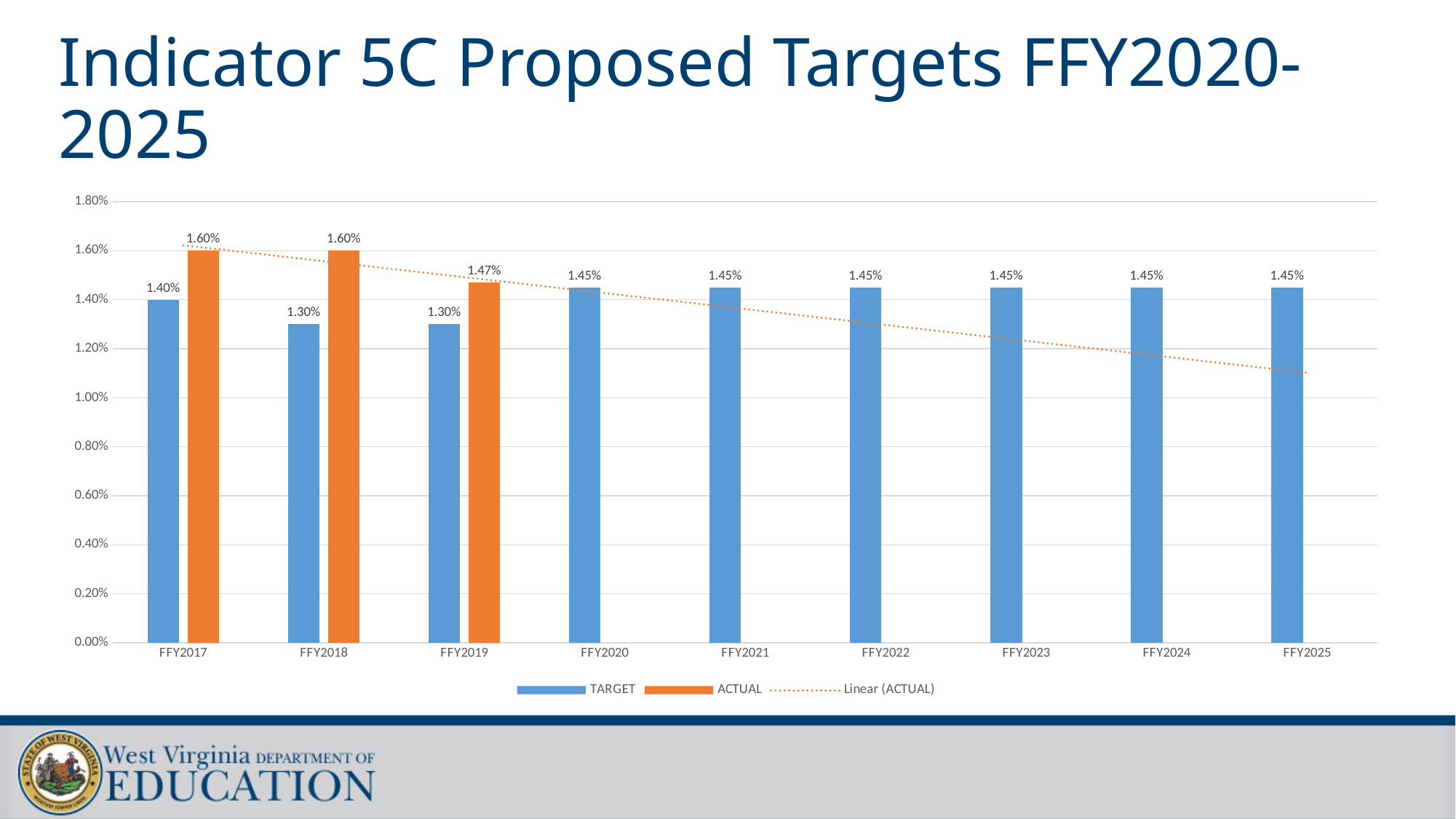
What is the ACTUAL value for FFY2019? 1.47% Is the TARGET value for FFY2020 greater or less than 1.20%? greater What kind of chart is shown on the slide? bar chart What is the TARGET value for FFY2017? 1.40% How many entries does the legend list? 3 Does the dotted Linear (ACTUAL) trend line rise or fall from FFY2017 to FFY2025? fall How many years are shown on the x axis? 9 What is the difference between the ACTUAL and TARGET values for FFY2018? 0.30% Which is larger for FFY2019, the TARGET or the ACTUAL value? ACTUAL What colour are the ACTUAL bars? orange What is the TARGET value for FFY2022? 1.45% Which year has the lowest TARGET value? FFY2018 and FFY2019